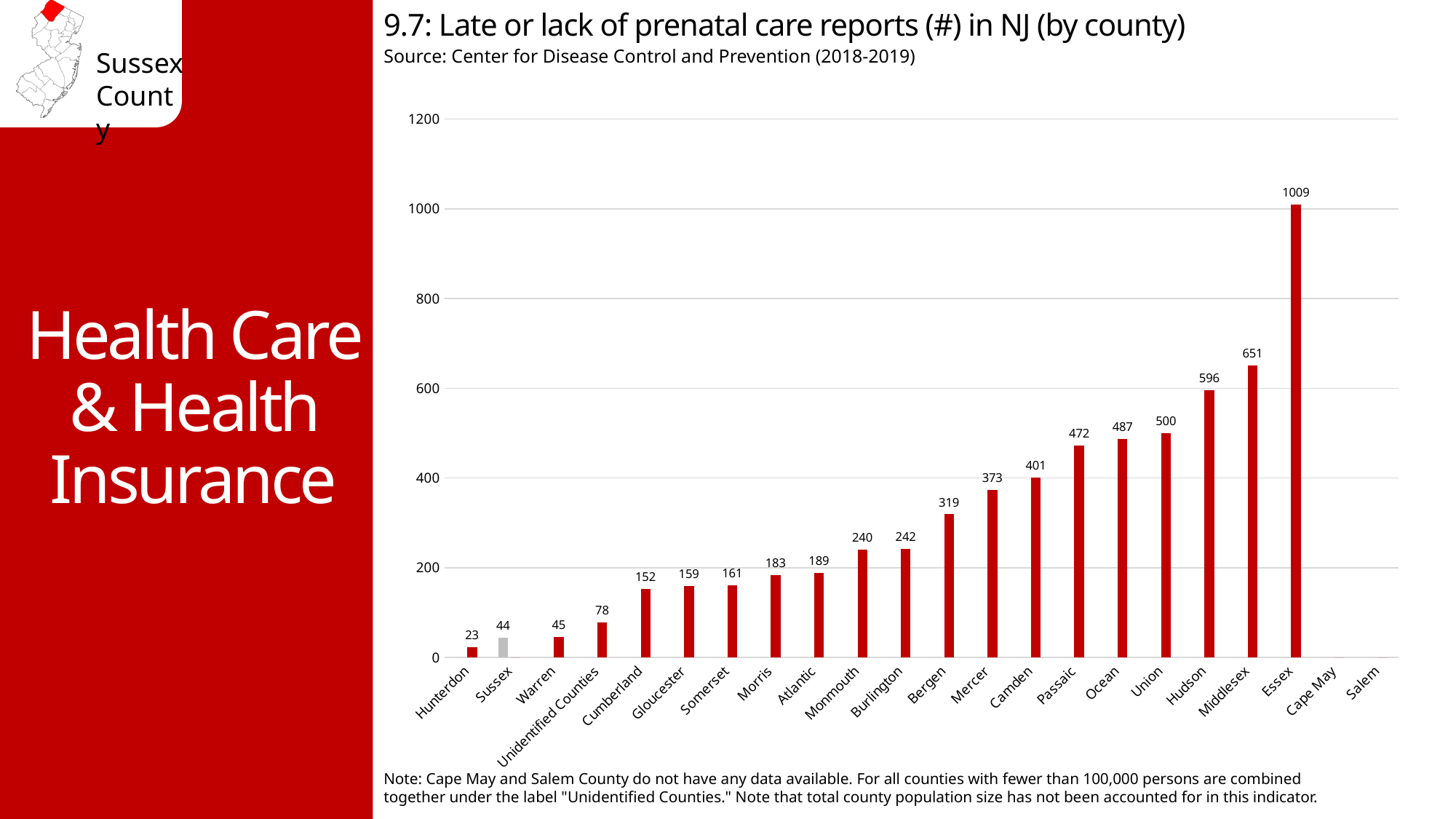
Do the bar values generally rise or fall from left to right along the x axis? Rise Which county with a plotted bar has the lowest number of reports? Hunterdon What is the value shown for Essex? 1009 What is the difference between the values for Middlesex and Hudson? 55 How many county categories are listed on the x axis? 22 Which has a larger value, Bergen or Mercer? Mercer Which county has the highest number of reports? Essex What is the value shown for Unidentified Counties? 78 Is the value for Passaic greater or less than 400? greater Which bar is coloured grey instead of red? Sussex What kind of chart is shown on the slide? Bar chart What is the number of late or lack of prenatal care reports for Sussex? 44